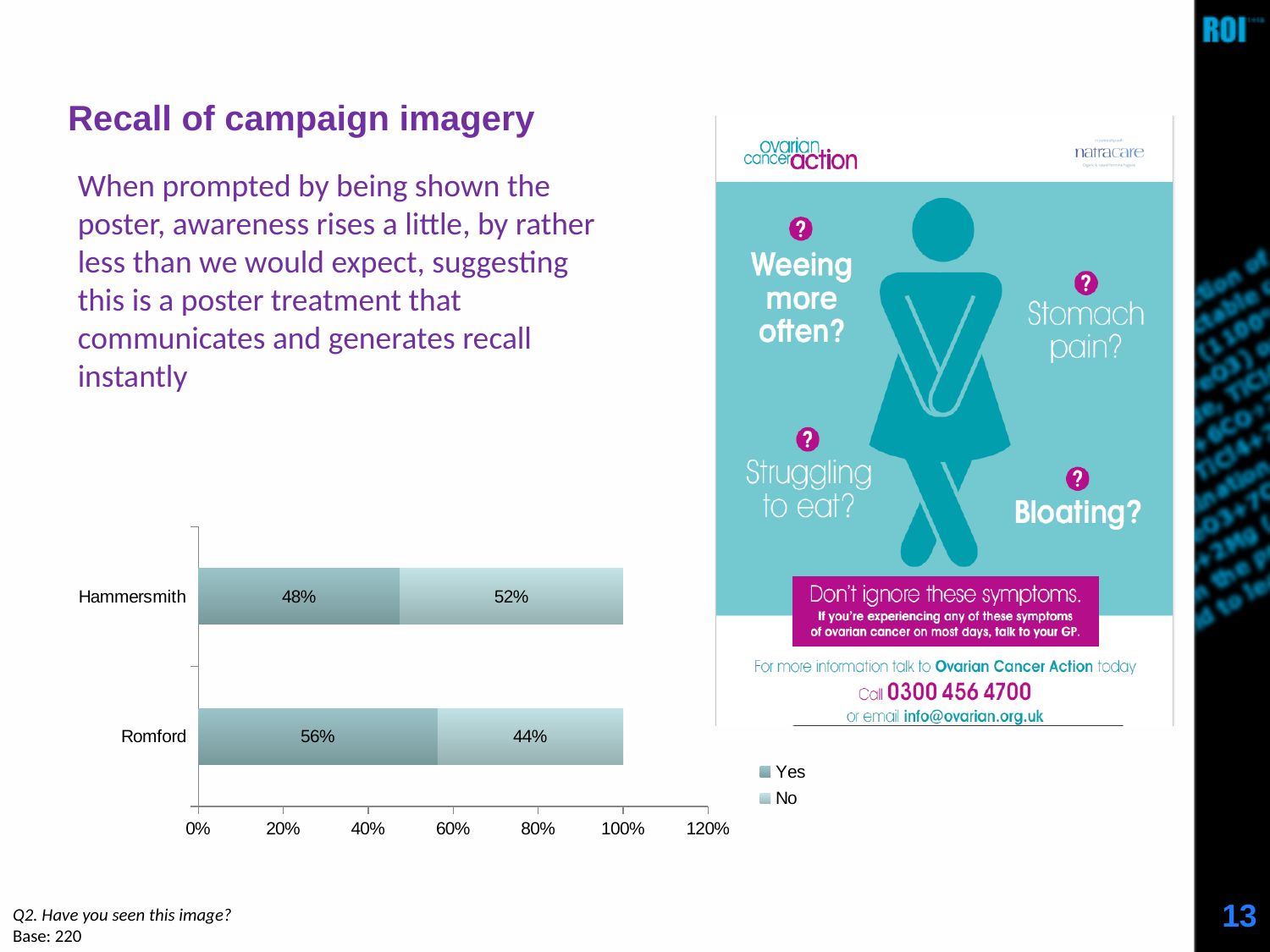
Is the Yes value for Hammersmith larger or smaller than the No value for Hammersmith? smaller What percentage of Romford respondents answered Yes? 56% Which location has the lower No percentage? Romford How many series does the legend list? 2 How many locations are shown on the chart? 2 What percentage of Hammersmith respondents answered No? 52% What kind of chart is shown on the slide? Stacked bar chart What is the difference between the Yes percentages for Romford and Hammersmith? 8% What percentage of Romford respondents answered No? 44% Which location has the higher Yes percentage? Romford What is the total of the Yes and No segments for the Romford bar? 100% What percentage of Hammersmith respondents answered Yes? 48%